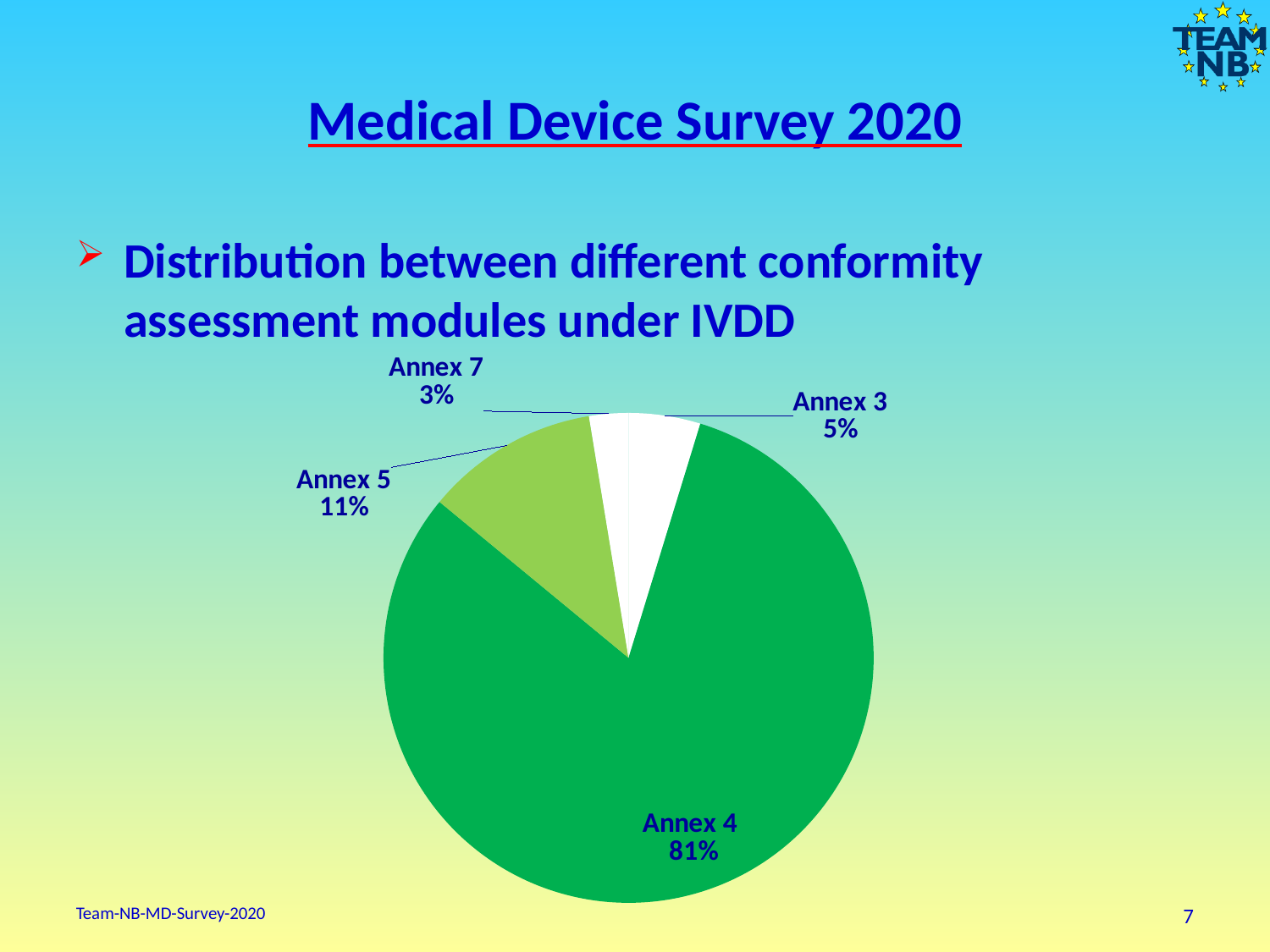
What kind of chart is shown on the slide? pie chart What is the value shown for Annex 7? 3% What is the title of the slide containing the pie chart? Medical Device Survey 2020 Which is larger, the share for Annex 3 or the share for Annex 5? Annex 5 What share of the pie does Annex 5 represent? 11% What share of the pie does Annex 4 represent? 81% How many slices does the pie chart have? 4 Which annex has the largest share of the pie? Annex 4 Which annex has the smallest share of the pie? Annex 7 What is the difference in percentage points between Annex 3 and Annex 7? 2 What is the value shown for Annex 3? 5% What is the difference in percentage points between Annex 4 and Annex 5? 70